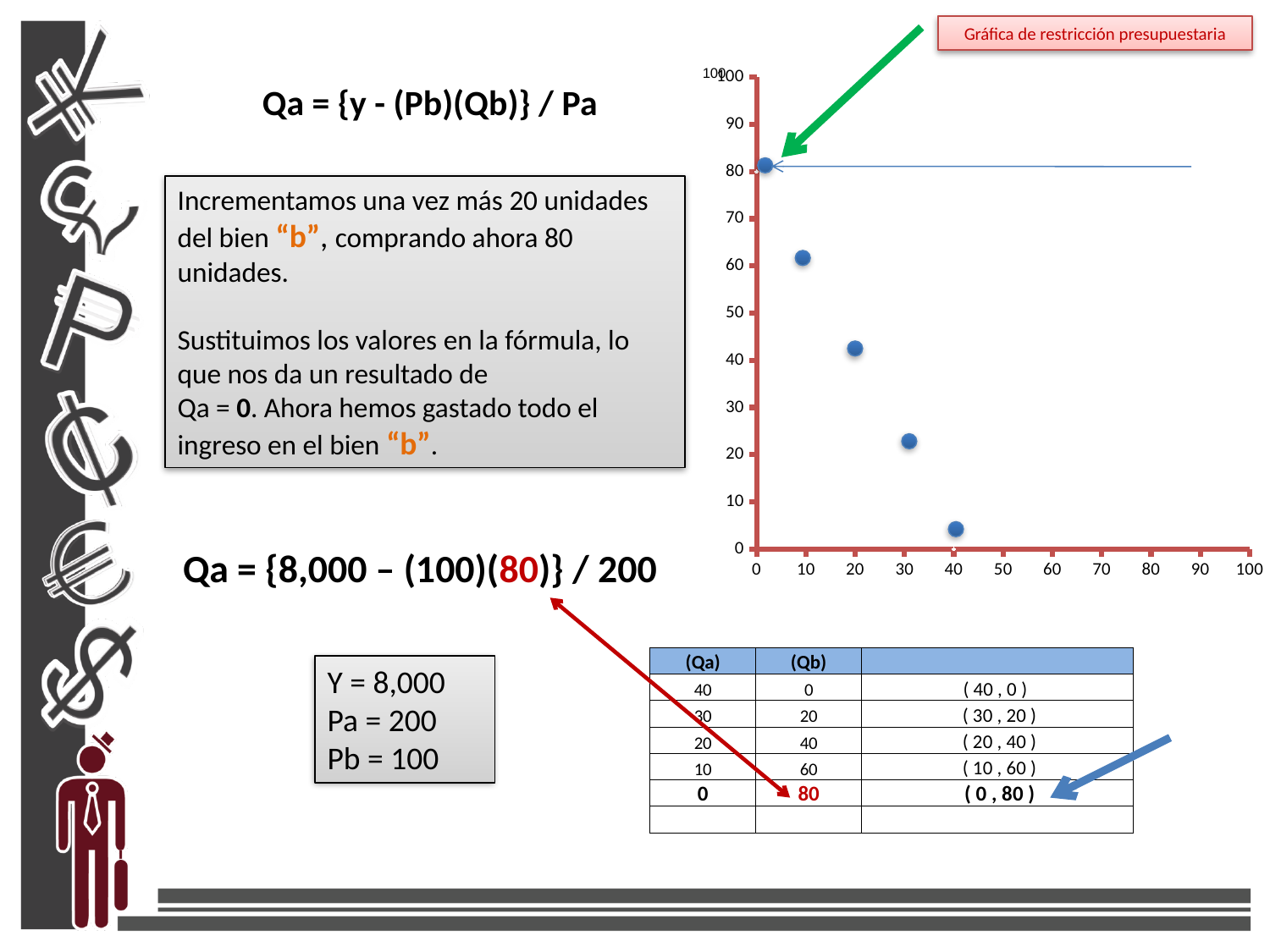
Is the y value of the point near x = 30 greater or less than 30? less Is the y value of the rightmost point (near x = 40) greater or less than 10? less As the x-axis value increases, do the plotted points rise or fall? fall Is the y value of the point near x = 10 greater or less than 50? greater How many data points are plotted on the chart? 5 What title does the red label with the green arrow give the chart? Gráfica de restricción presupuestaria Which plotted point has the highest y value: the leftmost point or the rightmost point? the leftmost point What kind of chart is shown on the slide? scatter chart Which point has a higher y value: the point near x = 10 or the point near x = 30? the point near x = 10 What is the maximum value shown on the chart's y-axis? 100